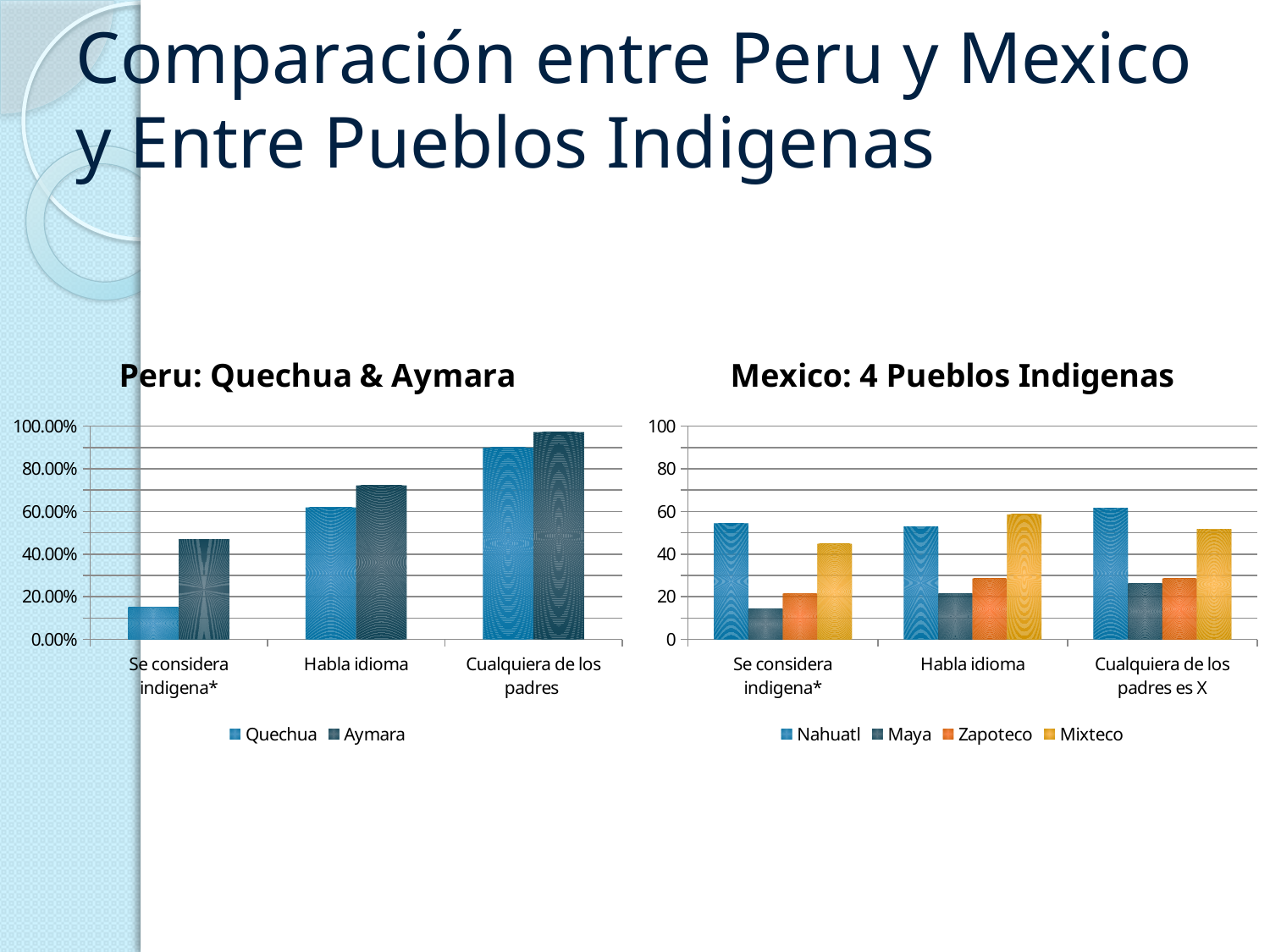
In the 'Peru: Quechua & Aymara' chart, which series has the larger value for 'Habla idioma', Quechua or Aymara? Aymara In the 'Peru: Quechua & Aymara' chart, is the Quechua value for 'Se considera indigena*' greater or less than 20.00%? less In the 'Mexico: 4 Pueblos Indigenas' chart, which series has the lowest value for 'Se considera indigena*'? Maya In the 'Peru: Quechua & Aymara' chart, is the Aymara value for 'Cualquiera de los padres' greater or less than 80.00%? greater What kind of chart is the 'Peru: Quechua & Aymara' chart? bar chart In the 'Peru: Quechua & Aymara' chart, do the Quechua values rise or fall from 'Se considera indigena*' to 'Cualquiera de los padres'? rise How many categories are shown on the x axis of the 'Peru: Quechua & Aymara' chart? 3 How many series does the legend of the 'Mexico: 4 Pueblos Indigenas' chart list? 4 In the 'Mexico: 4 Pueblos Indigenas' chart, which series has the highest value for 'Habla idioma'? Mixteco In the 'Mexico: 4 Pueblos Indigenas' chart, is the Maya value for 'Se considera indigena*' greater or less than 20? less In the 'Mexico: 4 Pueblos Indigenas' chart, which series is shown in orange according to the legend? Zapoteco How many series does the legend of the 'Peru: Quechua & Aymara' chart list? 2